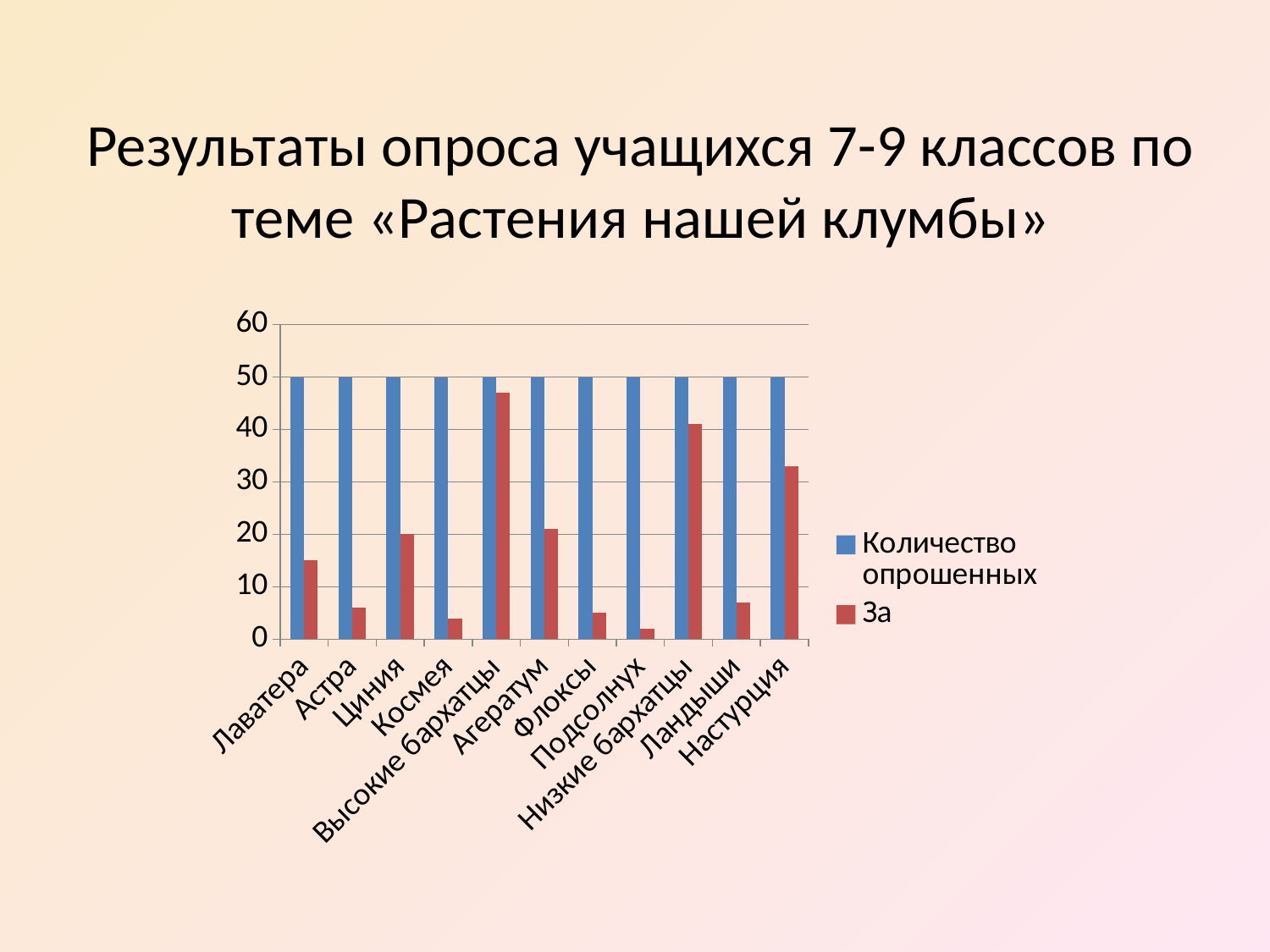
How many series does the legend list? 2 Which category has the highest value for the 'За' series? Высокие бархатцы Which has the larger 'За' value, Низкие бархатцы or Настурция? Низкие бархатцы Is the 'За' value for Высокие бархатцы greater or less than 40? greater Which category has the lowest value for the 'За' series? Подсолнух What kind of chart is shown on the slide? bar chart What is the value of 'Количество опрошенных' for Настурция? 50 Is the 'За' value for Астра greater or less than 10? less How many plant categories are shown on the x axis? 11 What are the two series named in the legend? Количество опрошенных and За What is the value of 'Количество опрошенных' for Лаватера? 50 Is the 'За' value for Настурция greater or less than 30? greater